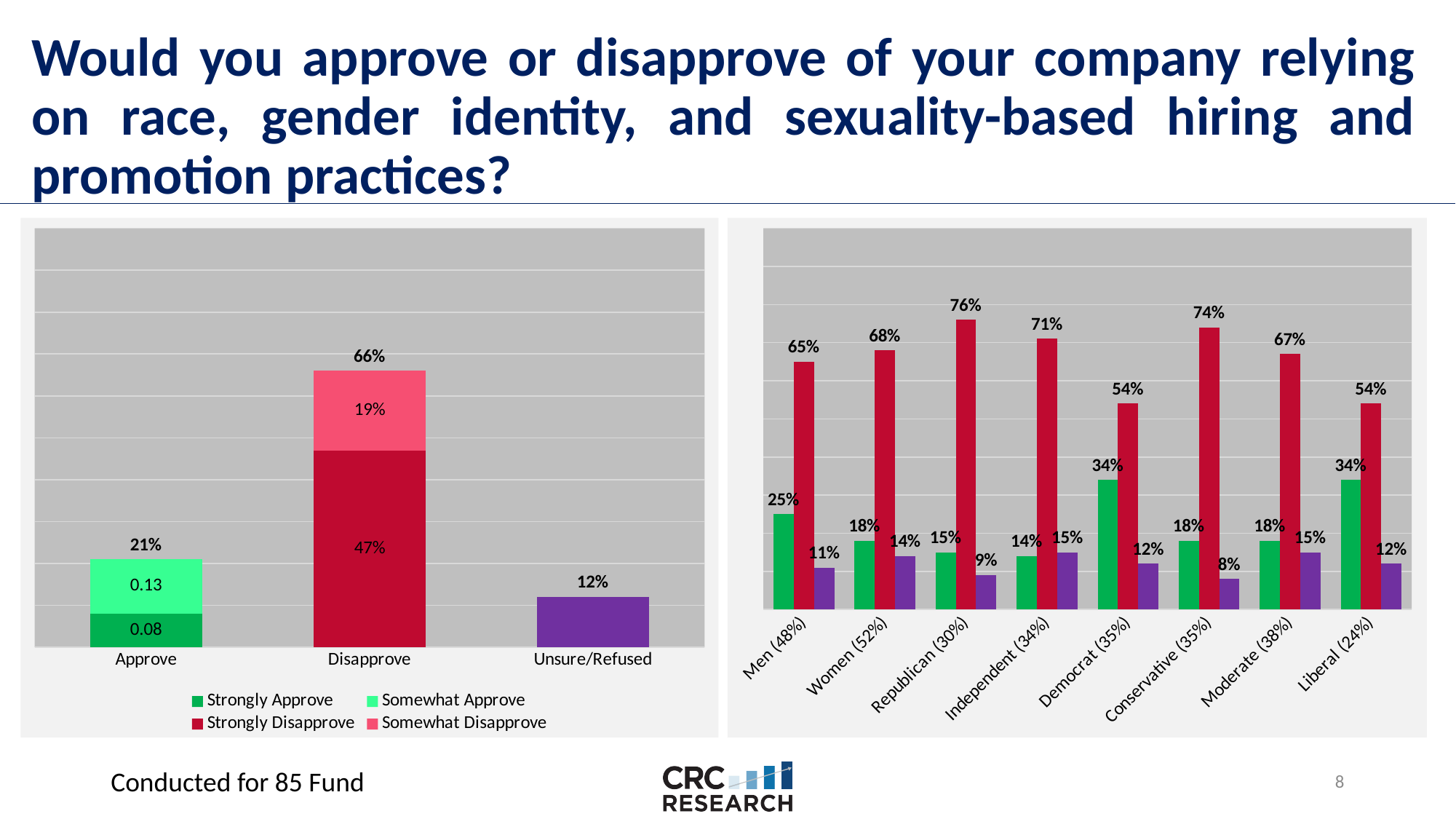
In the left chart, what is the total value shown for the Disapprove bar? 66% In the left chart, how many series does the legend list? 4 In the right chart, what is the value of the purple bar for Conservative (35%)? 8% In the left chart, what is the Strongly Disapprove value within the Disapprove bar? 47% What kind of chart is the right chart? Bar chart In the right chart, which group has the highest red bar? Republican (30%) In the right chart, how many groups are shown on the x axis? 8 In the left chart, what is the Somewhat Approve value within the Approve bar? 0.13 In the left chart, what is the value for Unsure/Refused? 12% In the right chart, what is the value of the green bar for Democrat (35%)? 34% In the right chart, which is larger: the red bar for Men (48%) or the red bar for Women (52%)? Women (52%) In the left chart, what is the difference between the Disapprove total and the Approve total? 45%